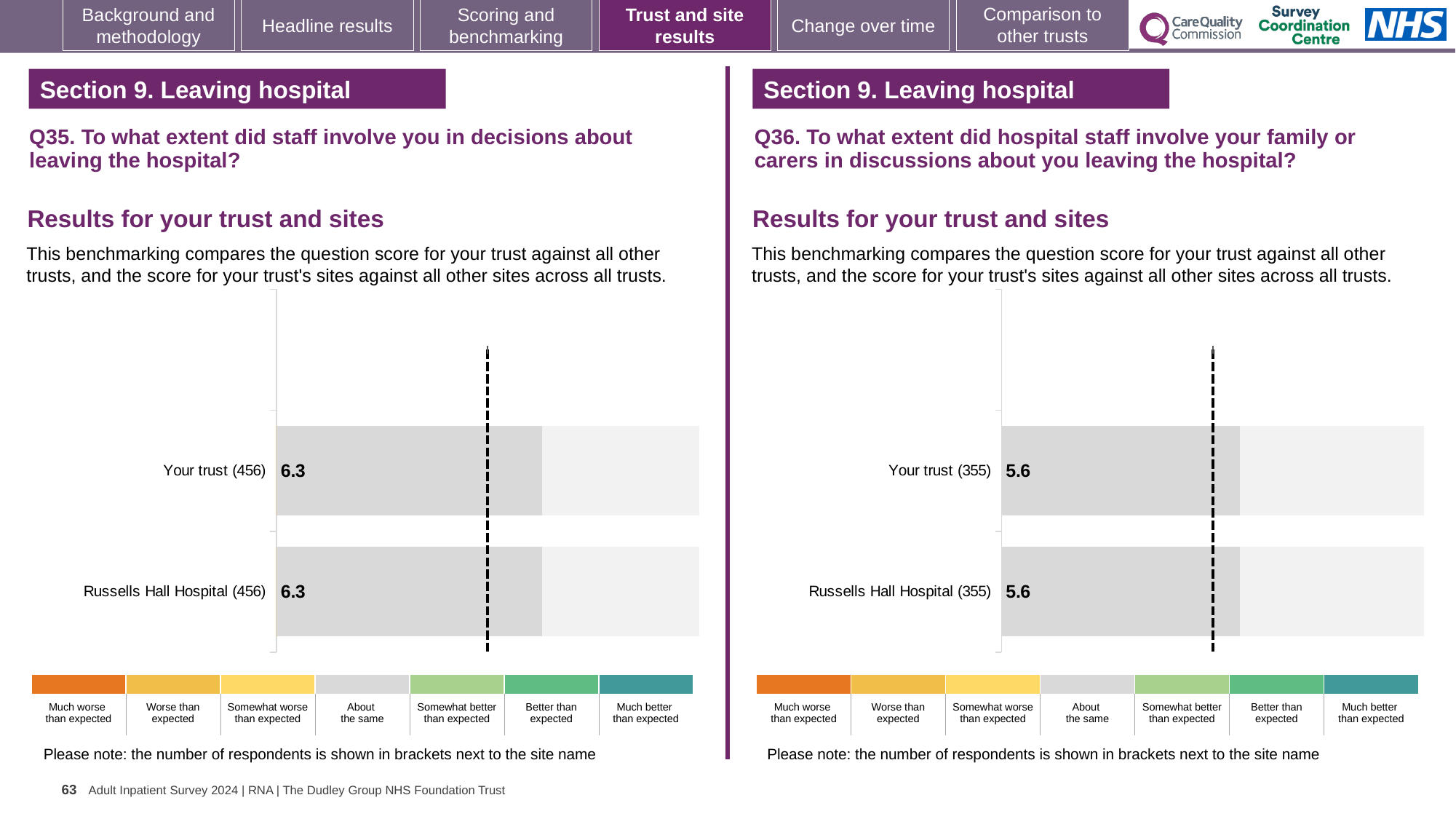
On the Q36 chart (right), what is the score for Russells Hall Hospital? 5.6 How many bars are plotted on the Q36 chart (right)? 2 How many bars are plotted on the Q35 chart (left)? 2 On the Q35 chart (left), what is the difference between the score for Your trust and the score for Russells Hall Hospital? 0 On the Q36 chart (right), what is the difference between the score for Your trust and the score for Russells Hall Hospital? 0 On the Q35 chart (left), what is the score for Russells Hall Hospital? 6.3 What kind of chart is used on the Q35 chart (left)? Bar chart On the Q36 chart (right), how many respondents are shown in brackets for Russells Hall Hospital? 355 Is the score for Your trust on the Q35 chart (left) larger or smaller than the score for Your trust on the Q36 chart (right)? Larger On the Q36 chart (right), what is the score for Your trust? 5.6 On the Q35 chart (left), how many respondents are shown in brackets for Your trust? 456 On the Q35 chart (left), what is the score for Your trust? 6.3